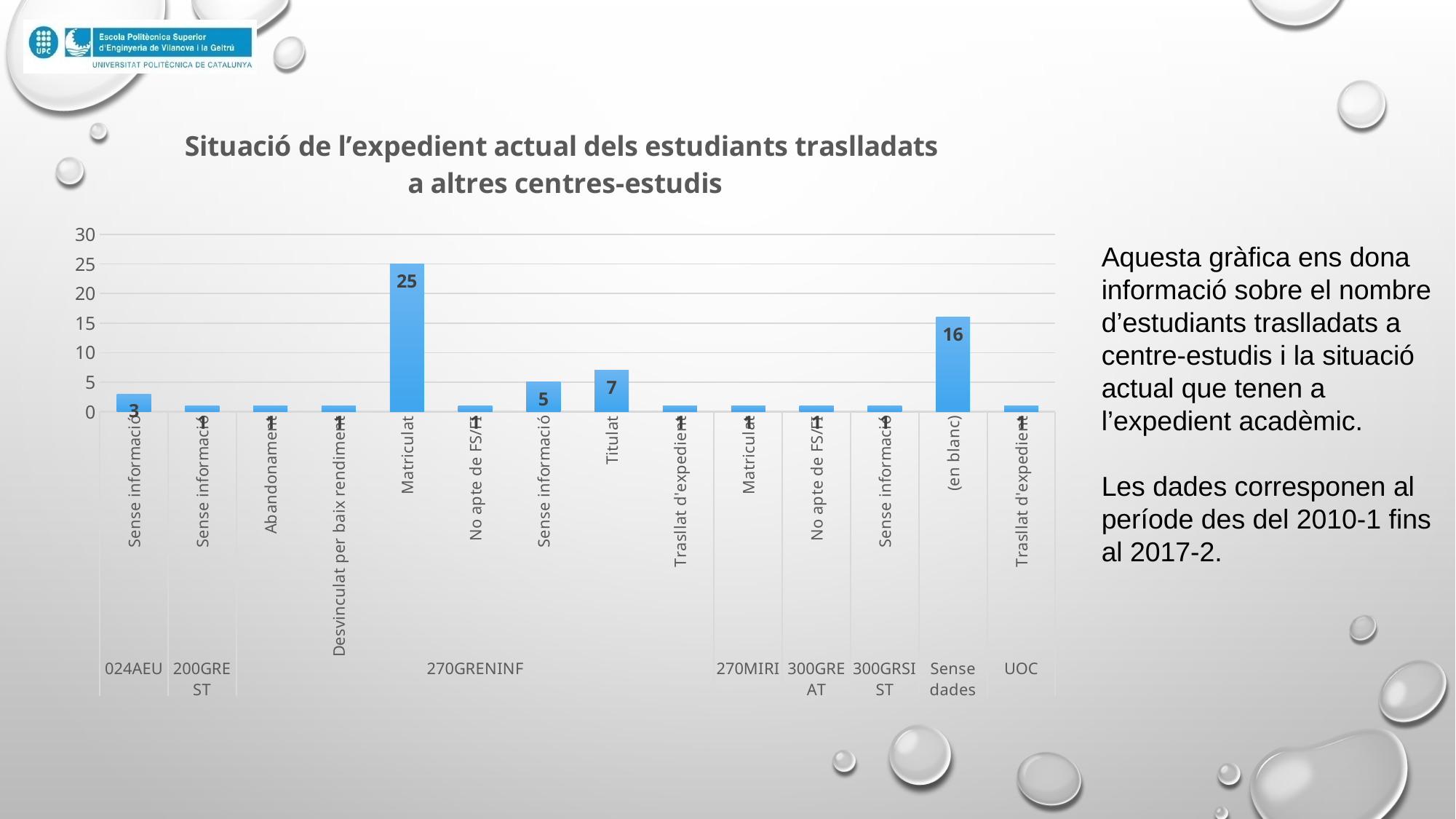
What is the value for Sense informació under 024AEU? 3 How many bars are plotted in the chart? 14 What kind of chart is shown on the slide? bar chart What is the value for Matriculat under 270GRENINF? 25 Is the value for (en blanc) under Sense dades greater or less than 20? less What is the difference between the value for Matriculat under 270GRENINF and the value for (en blanc) under Sense dades? 9 Which is larger: the value for Titulat under 270GRENINF or the value for Sense informació under 024AEU? Titulat under 270GRENINF What is the value for (en blanc) under Sense dades? 16 What is the value for Titulat under 270GRENINF? 7 What is the difference between the value for Titulat and the value for Sense informació, both under 270GRENINF? 2 Which category has the highest value? Matriculat (270GRENINF) What is the value for Sense informació under 270GRENINF? 5